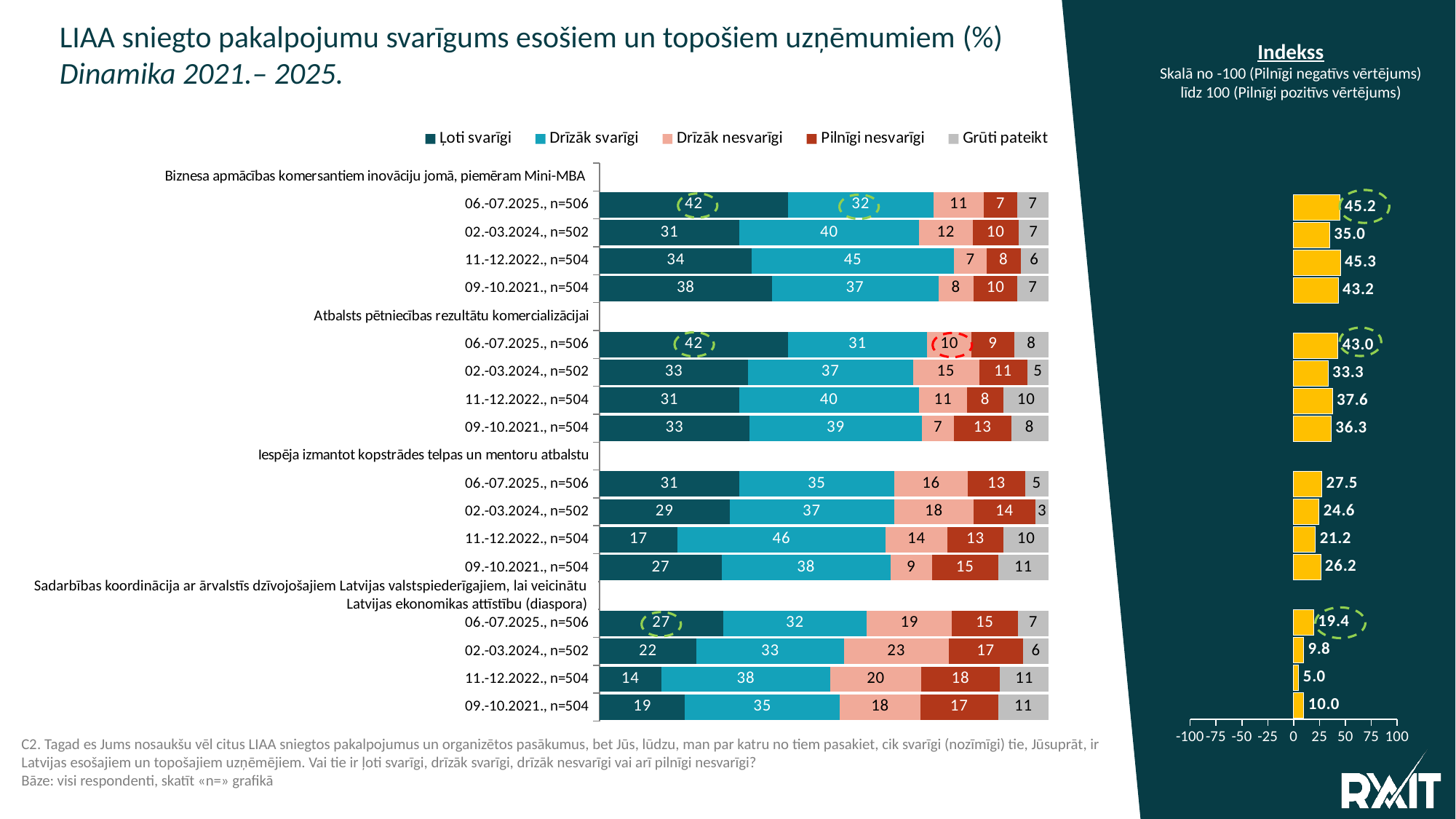
In the stacked bar chart, for "Biznesa apmācības komersantiem inovāciju jomā, piemēram Mini-MBA", is the "Drīzāk svarīgi" value larger in 11.-12.2022. or in 06.-07.2025.? 11.-12.2022. How many survey periods are shown for each service in the stacked bar chart? 4 How many series does the legend of the stacked bar chart list? 5 What is the title of the chart on the right side of the slide? Indekss In the Indekss chart, what is the difference between the 06.-07.2025. and 02.-03.2024. index values for the diaspora cooperation service? 9.6 In the Indekss chart, what is the index value for "Atbalsts pētniecības rezultātu komercializācijai" in 06.-07.2025., n=506? 43.0 In the Indekss chart, which period has the lowest index for "Sadarbības koordinācija ar ārvalstīs dzīvojošajiem Latvijas valstspiederīgajiem" (diaspora)? 11.-12.2022., n=504 In the stacked bar chart, what is the "Ļoti svarīgi" value for "Biznesa apmācības komersantiem inovāciju jomā, piemēram Mini-MBA" in the 06.-07.2025., n=506 row? 42 What kind of chart is the main chart on the left of the slide? Stacked bar chart In the stacked bar chart, what is the total of the 06.-07.2025., n=506 bar for "Iespēja izmantot kopstrādes telpas un mentoru atbalstu"? 100 In the stacked bar chart, what is the "Pilnīgi nesvarīgi" value for the diaspora cooperation service in 02.-03.2024., n=502? 17 In the Indekss chart, does the index for the diaspora cooperation service rise or fall from 11.-12.2022. to 06.-07.2025.? Rise